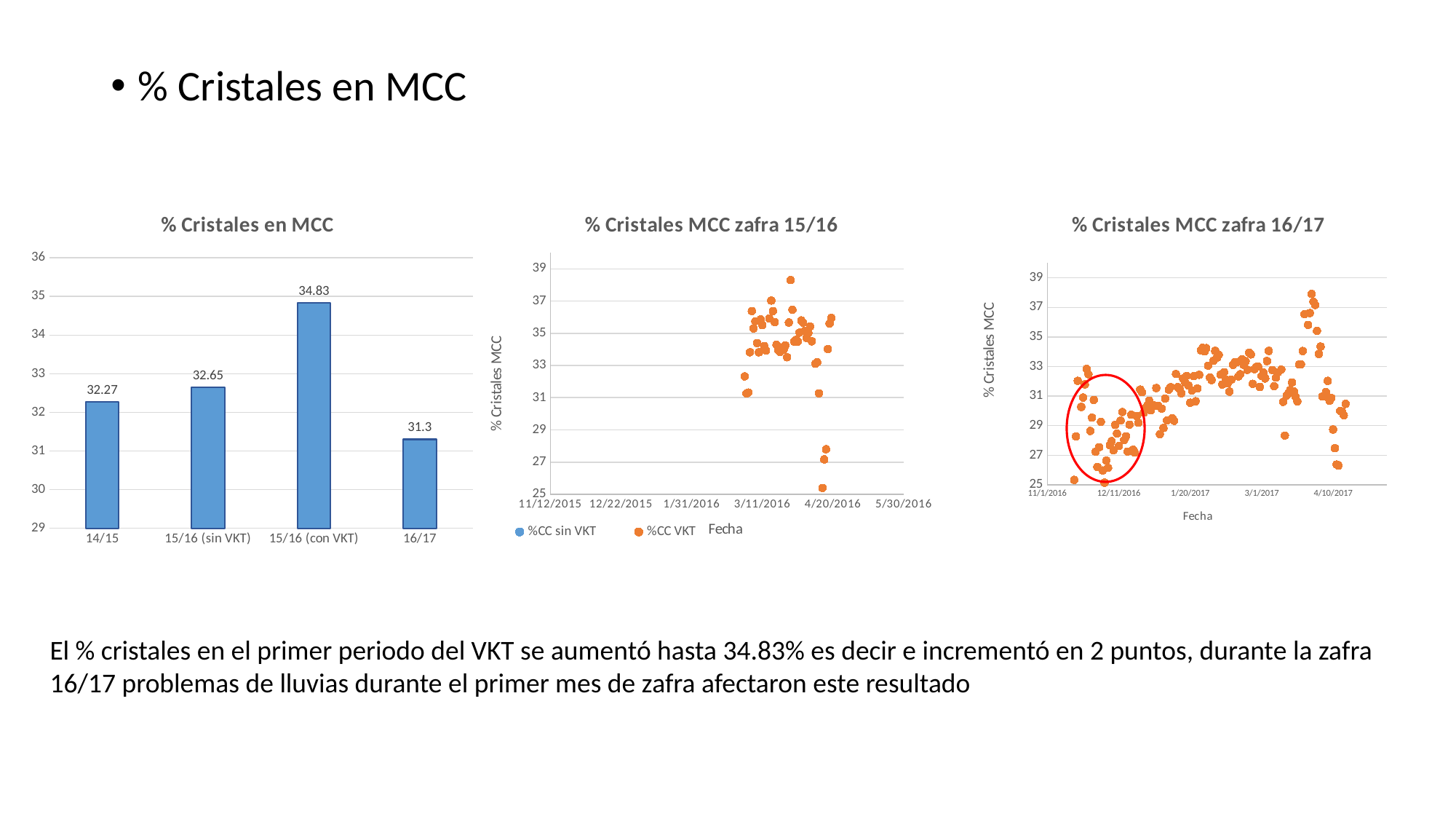
In the bar chart titled '% Cristales en MCC', what is the difference between the values for 15/16 (con VKT) and 15/16 (sin VKT)? 2.18 In the bar chart titled '% Cristales en MCC', what is the value for 16/17? 31.3 In the bar chart titled '% Cristales en MCC', which is larger, the value for 14/15 or the value for 16/17? 14/15 In the bar chart titled '% Cristales en MCC', which category has the highest value? 15/16 (con VKT) In the bar chart titled '% Cristales en MCC', what is the difference between the values for 15/16 (sin VKT) and 14/15? 0.38 In the bar chart titled '% Cristales en MCC', what is the value for 15/16 (con VKT)? 34.83 What kind of chart is the chart titled '% Cristales en MCC' on the left of the slide? Bar chart How many series does the legend of the chart titled '% Cristales MCC zafra 15/16' list? 2 In the bar chart titled '% Cristales en MCC', which category has the lowest value? 16/17 How many categories are shown in the bar chart titled '% Cristales en MCC'? 4 In the bar chart titled '% Cristales en MCC', what is the value for 14/15? 32.27 What kind of chart is the chart titled '% Cristales MCC zafra 16/17'? Scatter chart